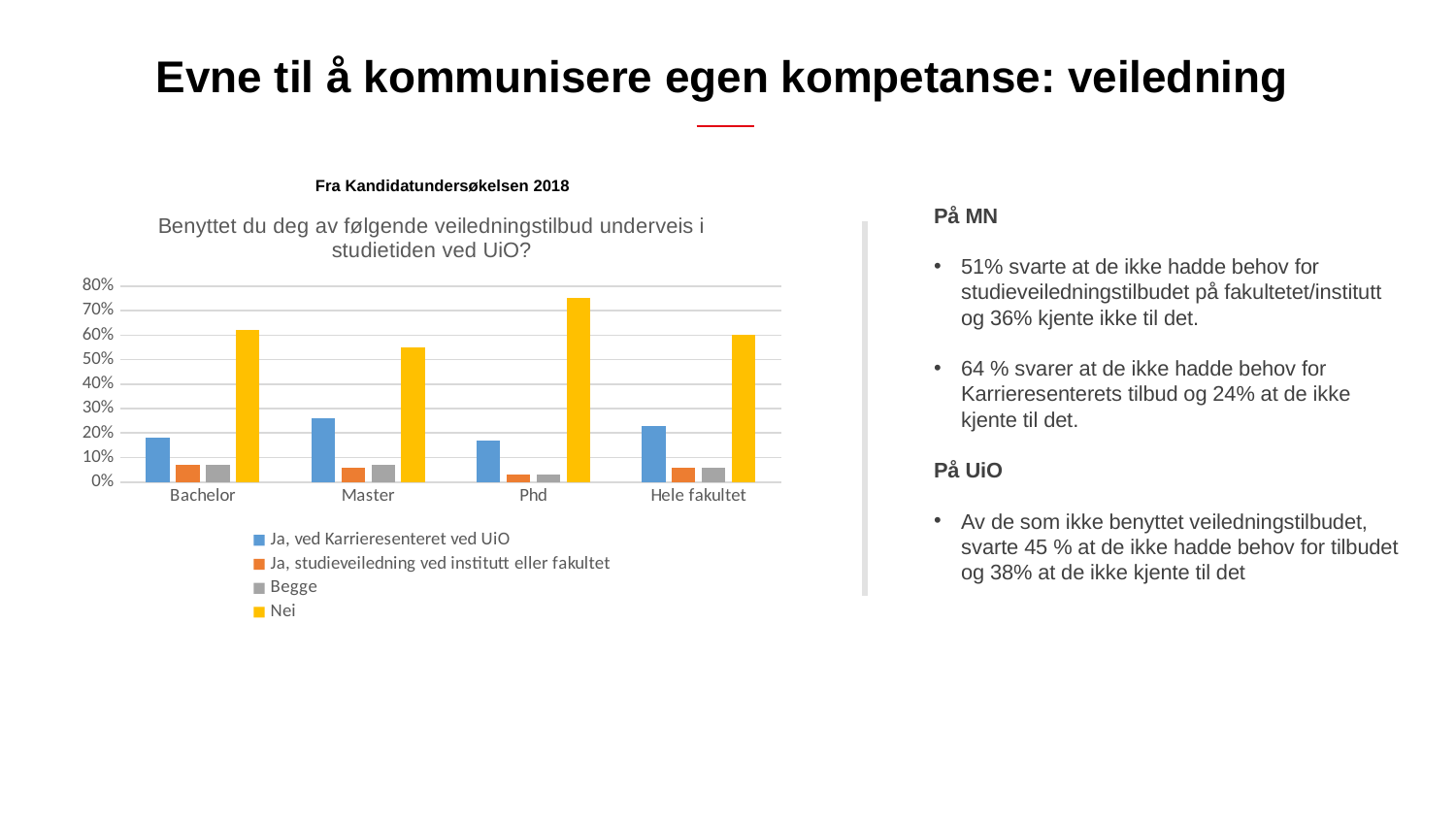
Which category has the lowest value for the 'Nei' series? Master How many categories are shown along the x axis of the chart? 4 Is the 'Ja, ved Karrieresenteret ved UiO' value for Master greater or less than 20%? greater What kind of chart is shown on the slide? bar chart Is the 'Ja, ved Karrieresenteret ved UiO' value for Bachelor greater or less than 10%? greater Is the 'Nei' value for Master greater or less than 60%? less Which category has the highest value for the 'Nei' series? Phd Which is larger: the 'Ja, ved Karrieresenteret ved UiO' value for Bachelor or for Master? Master Which series is shown in yellow in the chart? Nei Which category has the highest value for the 'Ja, ved Karrieresenteret ved UiO' series? Master How many series does the chart's legend list? 4